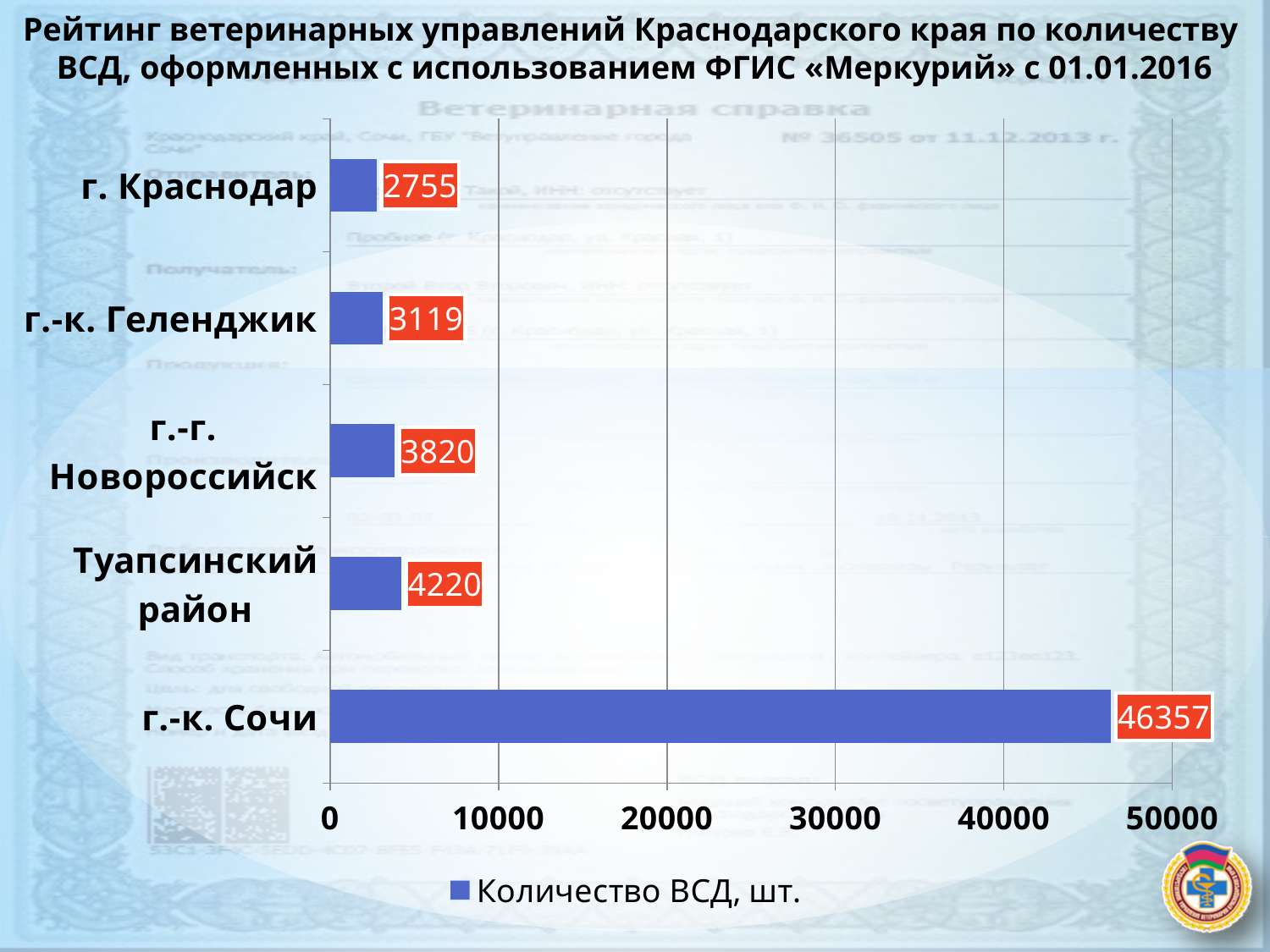
What is the legend entry of the chart? Количество ВСД, шт. What is the difference between the values for г.-г. Новороссийск and г.-к. Геленджик? 701 What is the value for Туапсинский район? 4220 What is the value for г. Краснодар? 2755 What is the value for г.-к. Сочи? 46357 How many categories are shown in the chart? 5 What kind of chart is shown on the slide? bar chart Which category has the lowest value? г. Краснодар Which is larger, the value for г.-к. Геленджик or г. Краснодар? г.-к. Геленджик What is the difference between the values for г.-к. Сочи and Туапсинский район? 42137 Which category has the highest value? г.-к. Сочи Is the value for г.-к. Сочи greater or less than 40000? greater